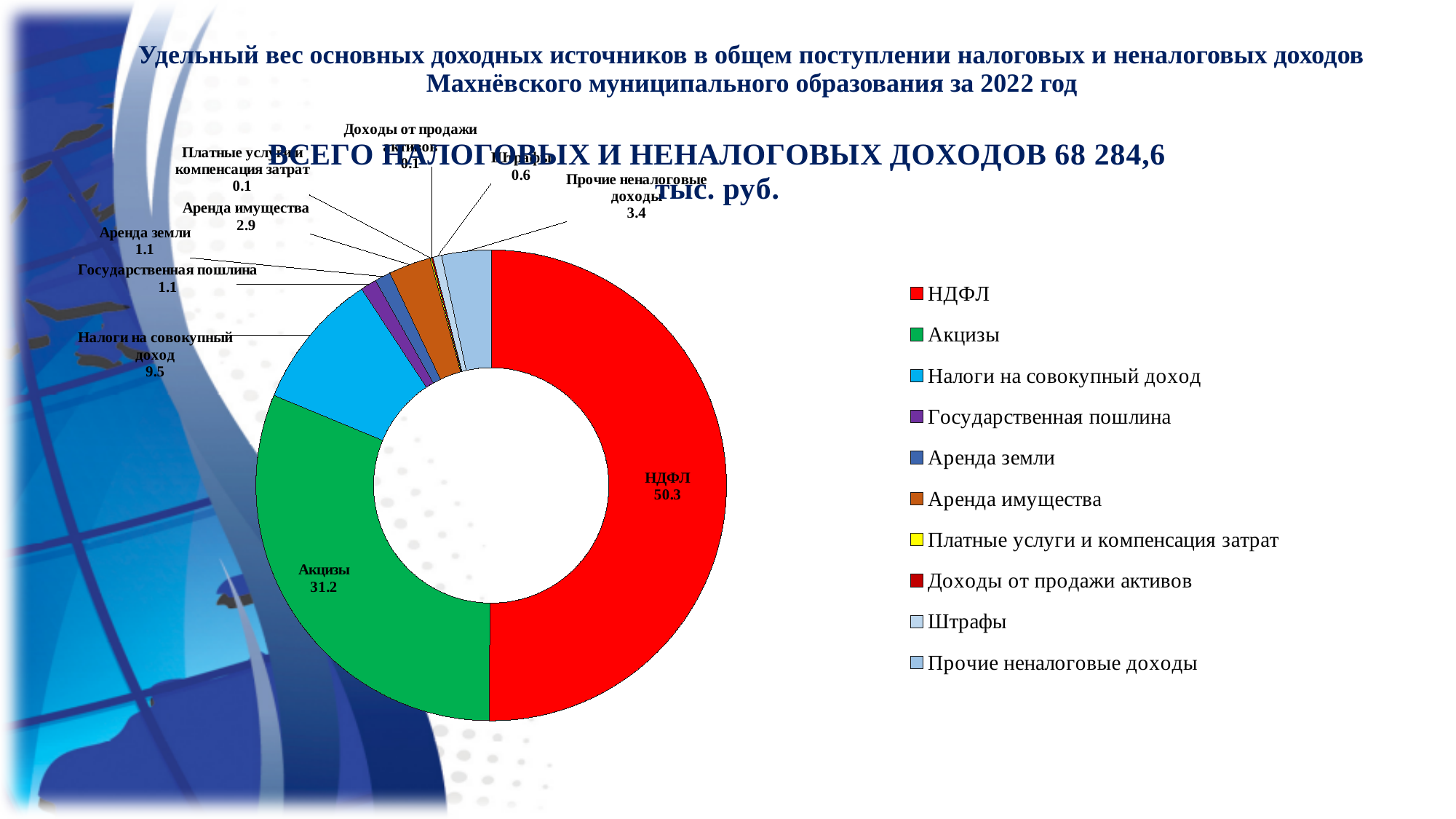
What colour represents НДФЛ in the chart? Red What is the value shown for Прочие неналоговые доходы? 3.4 Which category has the largest share on the chart? НДФЛ What is the value shown for Аренда имущества? 2.9 What is the value shown for НДФЛ on the chart? 50.3 What is the value shown for Налоги на совокупный доход? 9.5 Which is larger: Прочие неналоговые доходы or Аренда имущества? Прочие неналоговые доходы What is the value shown for Штрафы? 0.6 What kind of chart is shown on the slide? Doughnut (pie) chart What is the difference between the values for НДФЛ and Акцизы? 19.1 How many categories does the legend list? 10 What is the value shown for Акцизы on the chart? 31.2